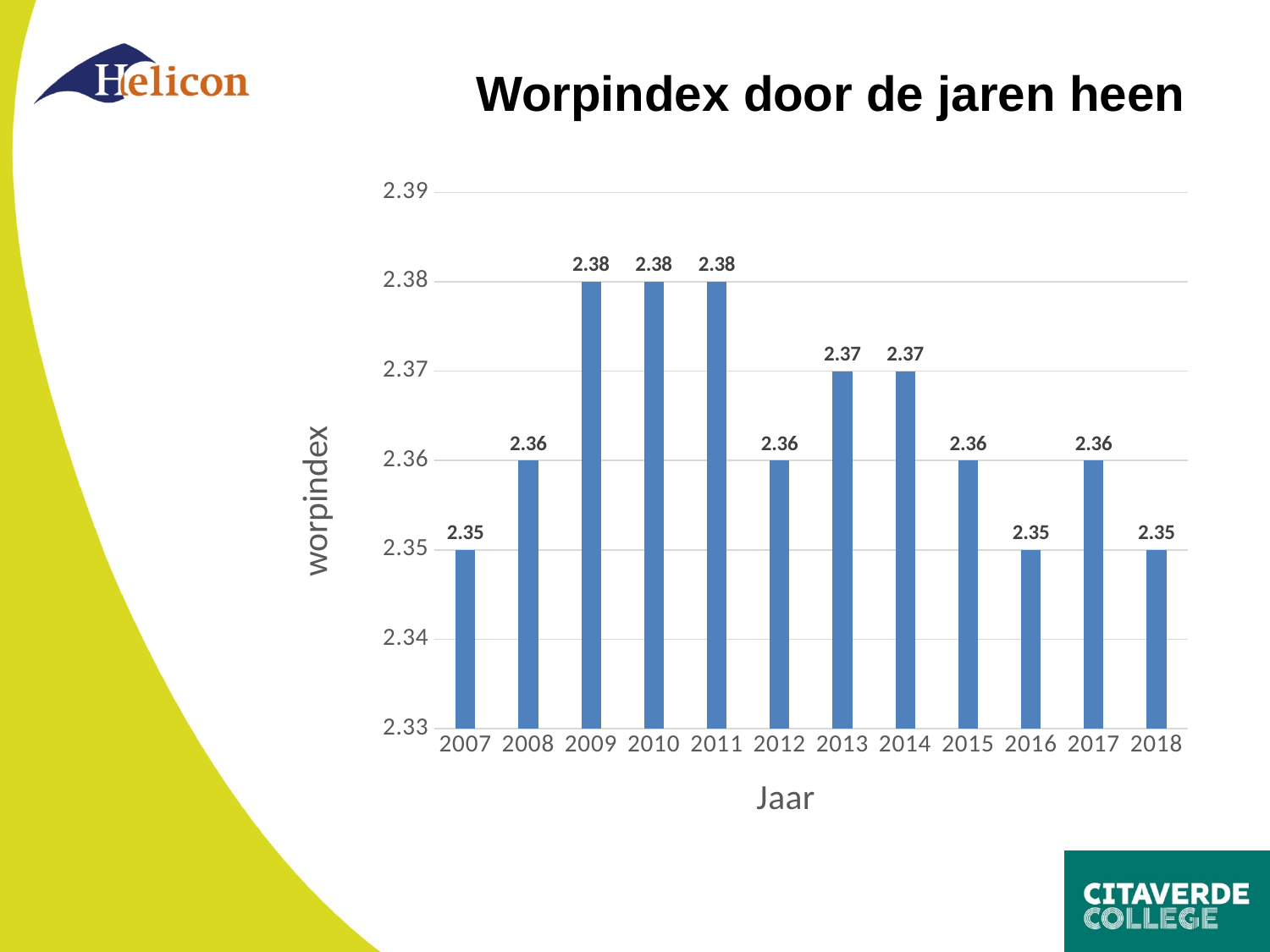
What is the difference between the values for 2009 and 2007? 0.03 What is the title of the chart? Worpindex door de jaren heen What is the lowest value shown in the chart? 2.35 What is the value for 2017? 2.36 What kind of chart is shown on the slide? bar chart How many years are shown on the x axis? 12 What is the value for 2013? 2.37 Which year has the larger value, 2012 or 2013? 2013 What is the highest value shown in the chart? 2.38 Is the value for 2010 greater or less than 2.37? greater Do the values rise or fall from 2007 to 2009? rise What is the value for 2007? 2.35